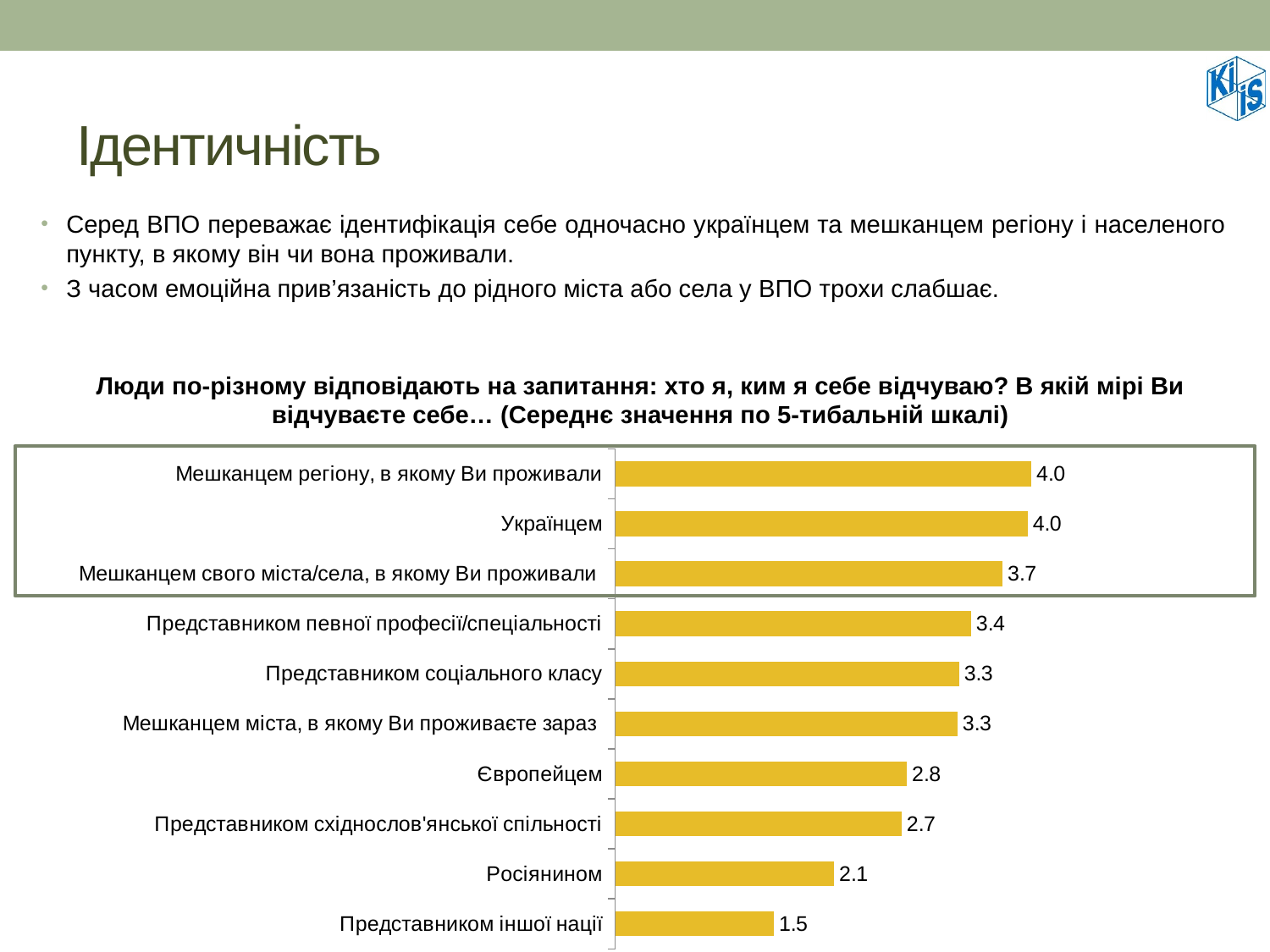
What is the value for "Європейцем"? 2.8 What is the highest value shown in the chart? 4.0 What is the value for "Представником певної професії/спеціальності"? 3.4 What is the value for "Росіянином"? 2.1 How many categories are shown in the chart? 10 Which category has the lowest value? Представником іншої нації What is the difference between the values for "Українцем" and "Росіянином"? 1.9 Which is larger: the value for "Представником соціального класу" or the value for "Представником іншої нації"? Представником соціального класу What is the value for "Мешканцем свого міста/села, в якому Ви проживали"? 3.7 What colour are the bars in the chart? Yellow What kind of chart is shown on the slide? Bar chart What is the difference between the values for "Європейцем" and "Представником східнослов'янської спільності"? 0.1